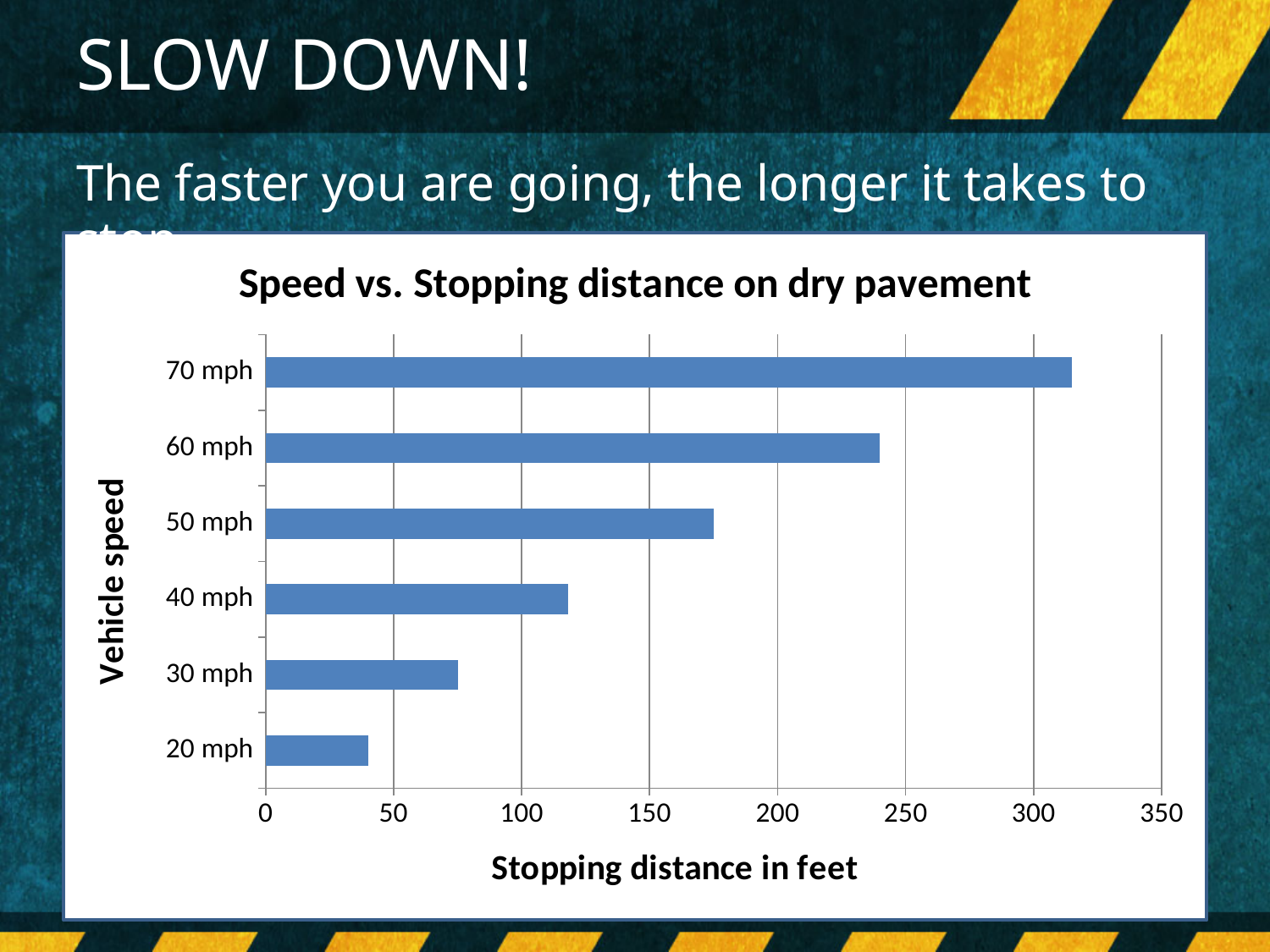
Is the stopping distance for 40 mph greater or less than 100 feet? greater What is the label of the horizontal axis of the chart? Stopping distance in feet What is the title of the chart? Speed vs. Stopping distance on dry pavement Is the stopping distance for 20 mph greater or less than 50 feet? less Which has a longer stopping distance, 30 mph or 50 mph? 50 mph How many vehicle speed categories are plotted in the chart? 6 Is the stopping distance for 50 mph greater or less than 150 feet? greater Which vehicle speed has the longest stopping distance? 70 mph Which vehicle speed has the shortest stopping distance? 20 mph What type of chart is shown on the slide? bar chart